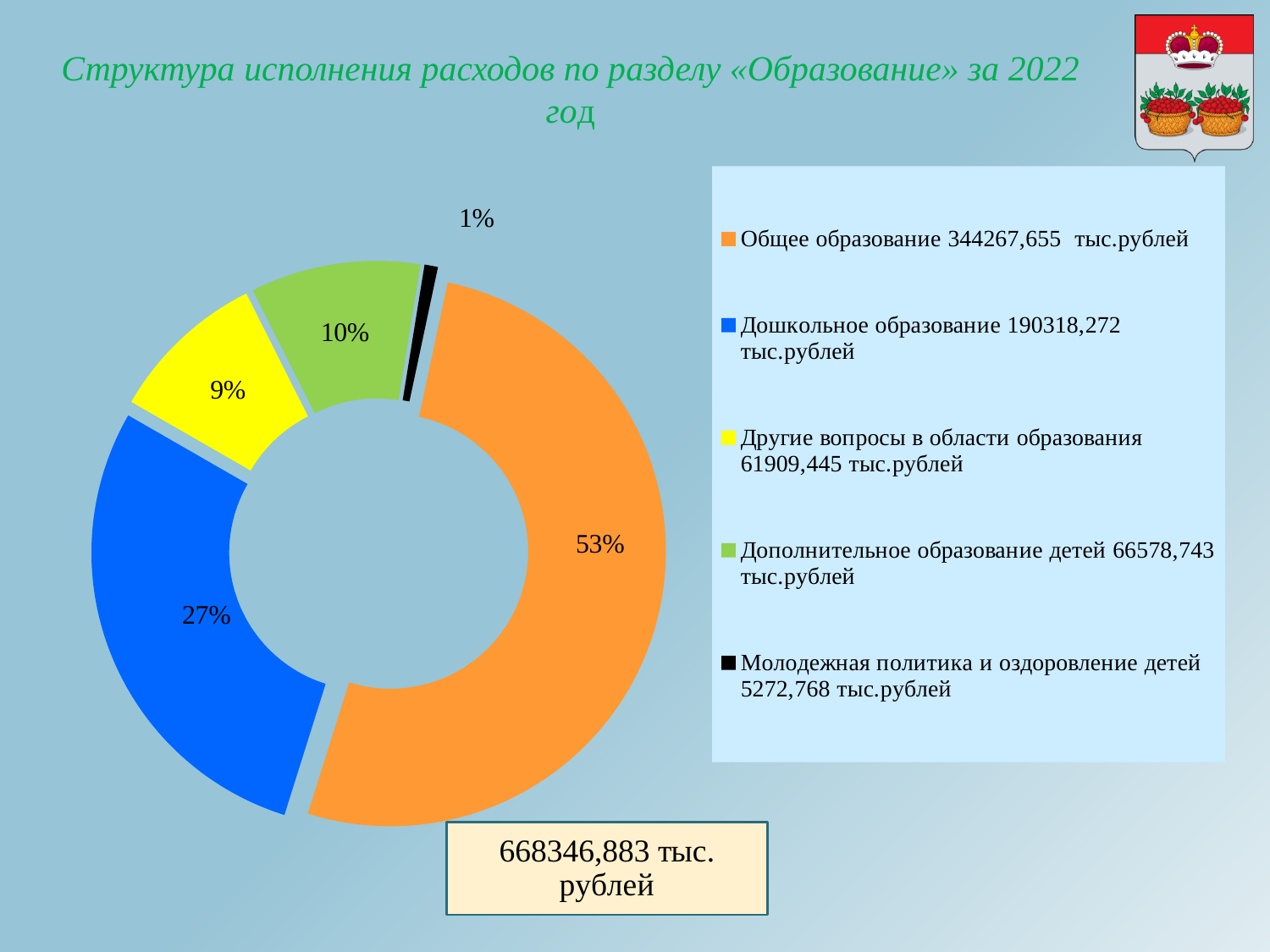
What percentage is shown for Дошкольное образование? 27% What percentage is shown for Другие вопросы в области образования? 9% What colour represents Дошкольное образование in the chart? blue Which is larger: the share for Дополнительное образование детей or for Другие вопросы в области образования? Дополнительное образование детей What kind of chart is shown on the slide? doughnut (pie) chart How many categories does the chart show? 5 What percentage is shown for Дополнительное образование детей? 10% Which category has the largest share of the chart? Общее образование What share of the chart does Общее образование account for? 53% What is the difference in percentage points between Общее образование and Дошкольное образование? 26% According to the legend, what amount in тыс.рублей is given for Молодежная политика и оздоровление детей? 5272,768 тыс.рублей Which category has the smallest share of the chart? Молодежная политика и оздоровление детей